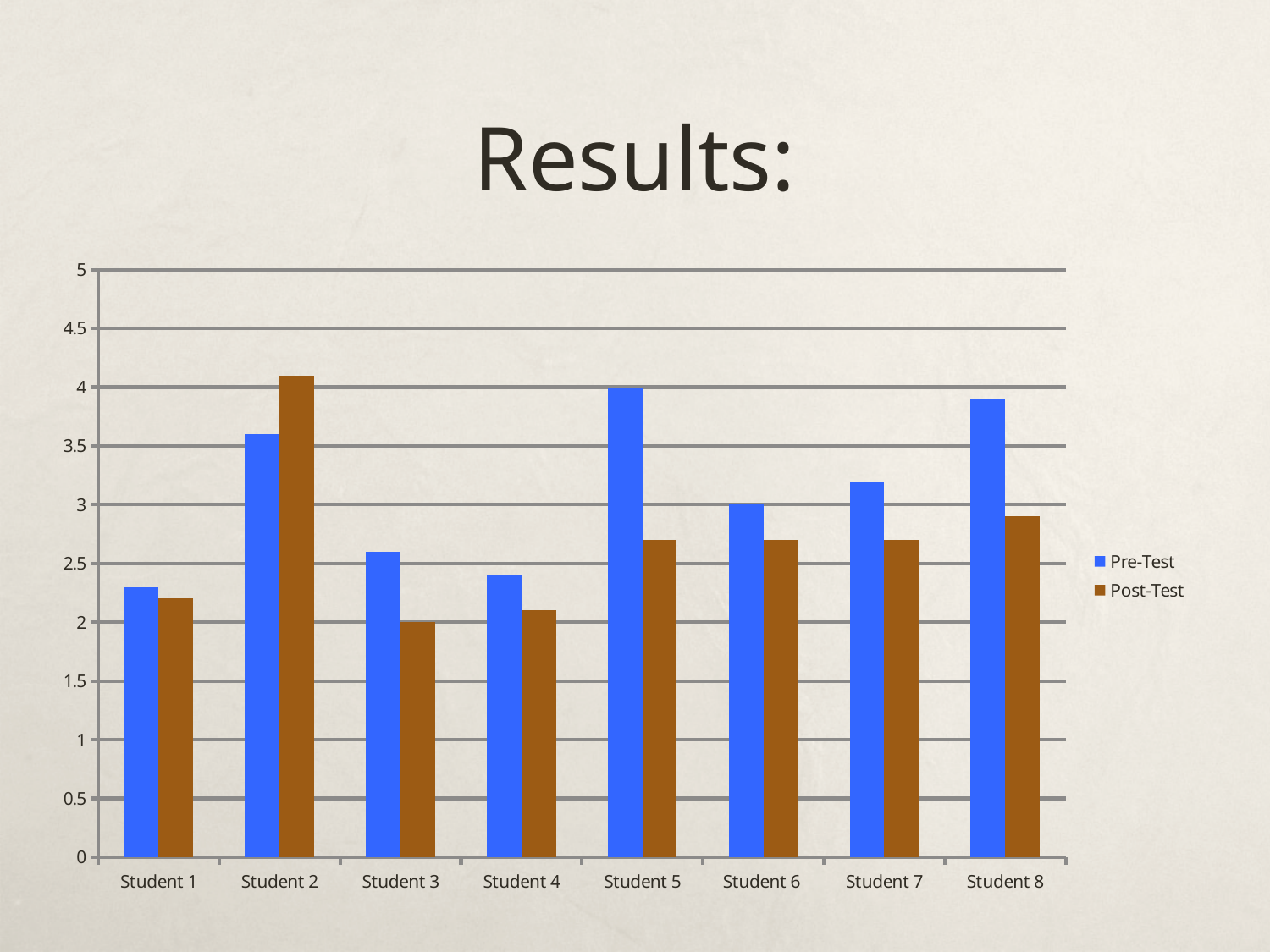
How many students are shown on the x axis? 8 Is the Pre-Test value for Student 4 greater or less than 2.5? less Which student has the highest Post-Test value? Student 2 What is the Pre-Test value for Student 6? 3 What is the Pre-Test value for Student 5? 4 Which student has the lowest Pre-Test value? Student 1 For Student 8, which is larger, the Pre-Test or the Post-Test value? Pre-Test Is the Post-Test value for Student 2 greater or less than 4? greater What is the title of the chart slide? Results: What is the Post-Test value for Student 3? 2 How many series does the legend list? 2 What kind of chart is shown on the slide? bar chart